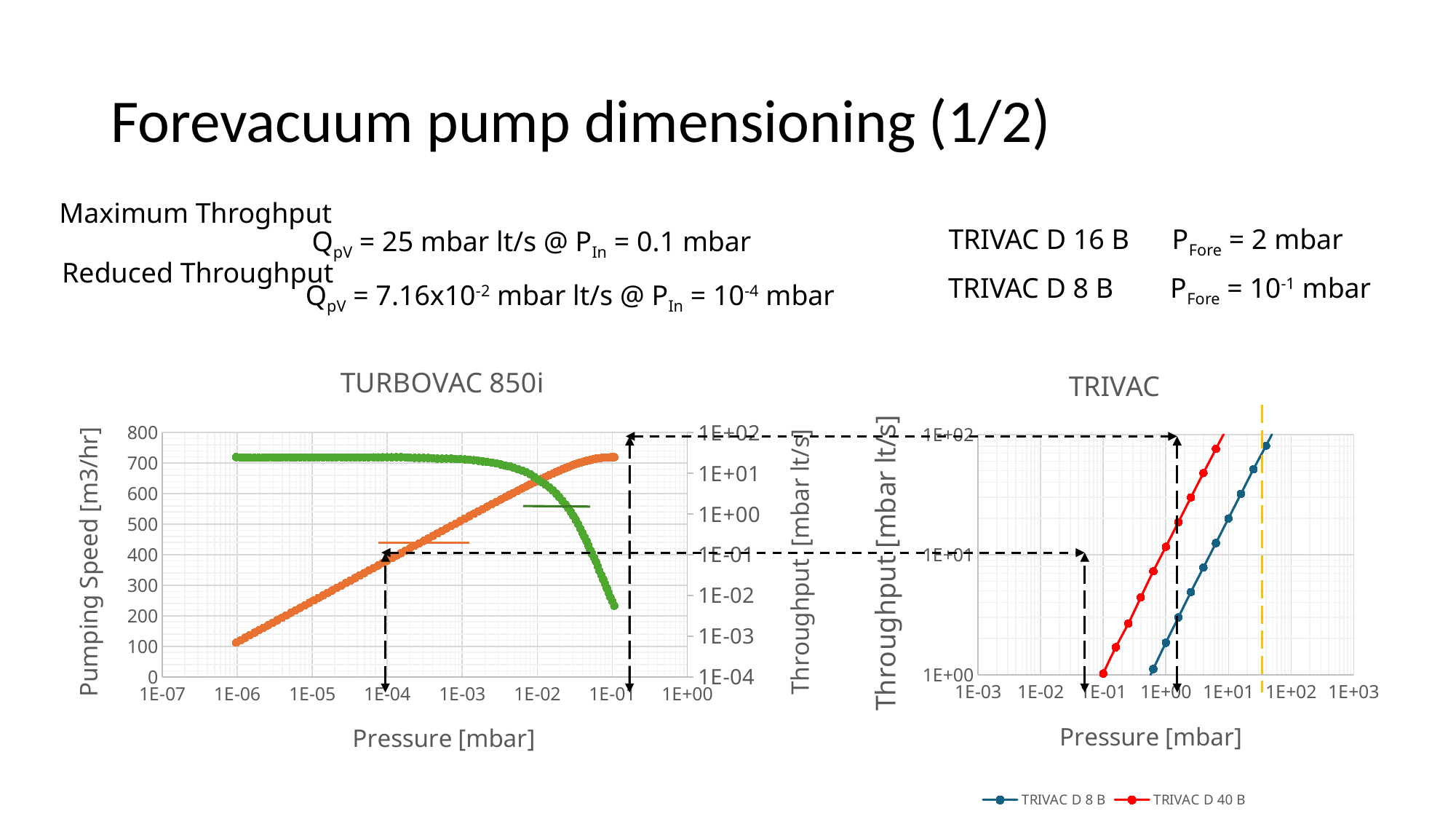
In the TRIVAC chart, which series has the higher throughput at a pressure of 1E+01 mbar, TRIVAC D 8 B or TRIVAC D 40 B? TRIVAC D 40 B What kind of chart is the TURBOVAC 850i chart? line chart How many series does the legend of the TRIVAC chart list? 2 In the TURBOVAC 850i chart, is the pumping speed at 1E-05 mbar greater or less than 600 m3/hr? greater In the TRIVAC chart, do the throughput values rise or fall as pressure increases? rise What kind of chart is the TRIVAC chart? line chart How many tick labels are shown on the x axis of the TRIVAC chart? 7 In the TURBOVAC 850i chart, does the orange throughput curve rise or fall as pressure increases? rise In the TURBOVAC 850i chart, does the green pumping speed curve rise or fall between 1E-02 and 1E-01 mbar? fall What are the two series named in the legend of the TRIVAC chart? TRIVAC D 8 B and TRIVAC D 40 B What is the x-axis label of the TURBOVAC 850i chart? Pressure [mbar] In the TURBOVAC 850i chart, is the pumping speed at 1E-01 mbar greater or less than 300 m3/hr? less